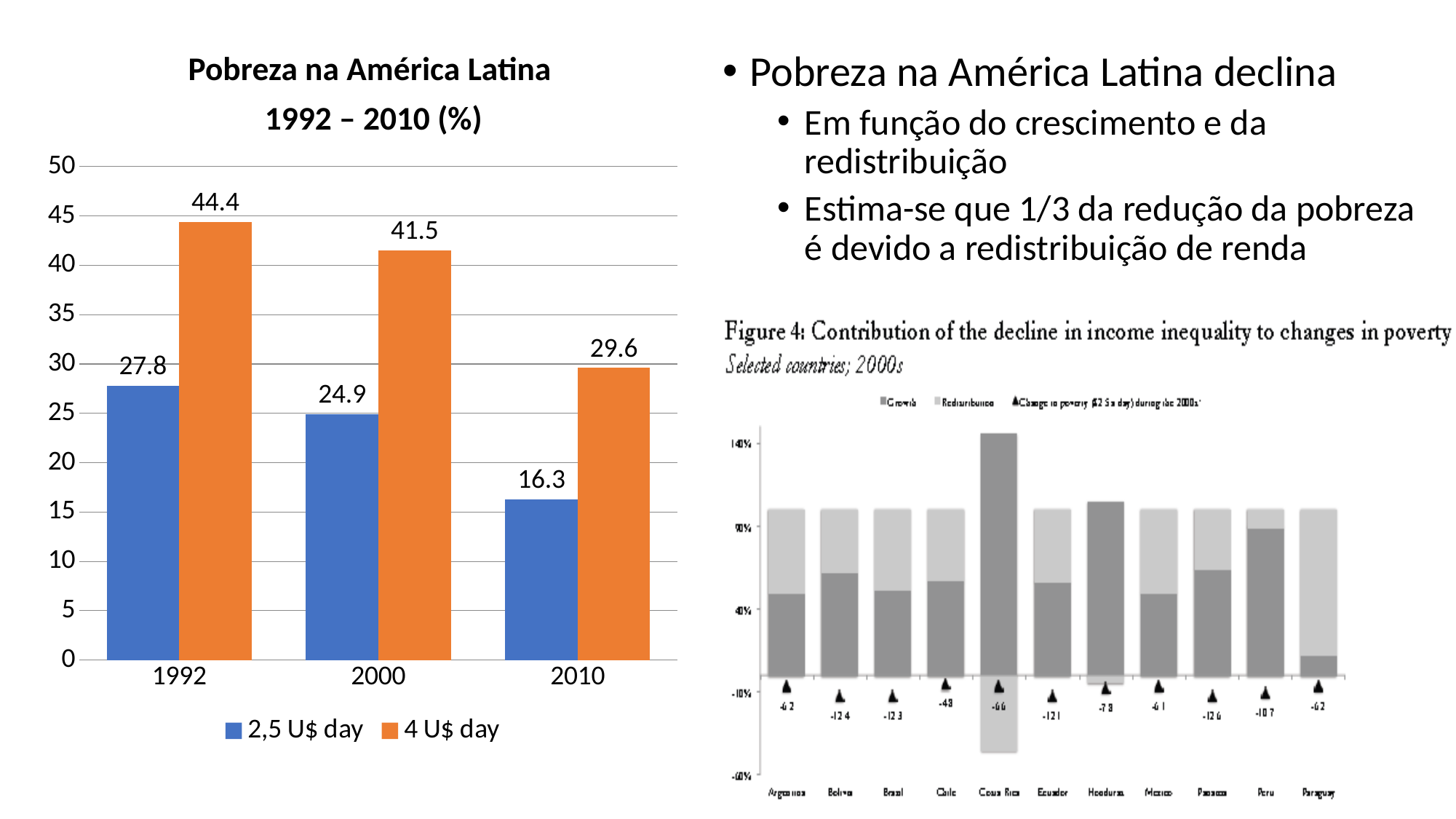
In the chart 'Pobreza na América Latina 1992 – 2010 (%)', what is the value for 4 U$ day in 1992? 44.4 What kind of chart is 'Pobreza na América Latina 1992 – 2010 (%)'? Bar chart In the chart 'Pobreza na América Latina 1992 – 2010 (%)', which year has the lowest value for 2,5 U$ day? 2010 In the chart 'Pobreza na América Latina 1992 – 2010 (%)', which series has the larger value in 2000, 2,5 U$ day or 4 U$ day? 4 U$ day In the chart 'Pobreza na América Latina 1992 – 2010 (%)', how many series does the legend list? 2 In the chart 'Pobreza na América Latina 1992 – 2010 (%)', what is the difference between the 4 U$ day and 2,5 U$ day values in 1992? 16.6 In the chart 'Pobreza na América Latina 1992 – 2010 (%)', do the 4 U$ day values rise or fall from 1992 to 2010? Fall In the chart 'Pobreza na América Latina 1992 – 2010 (%)', by how much did the 2,5 U$ day value fall from 1992 to 2010? 11.5 In the chart 'Pobreza na América Latina 1992 – 2010 (%)', which colour represents the 2,5 U$ day series? Blue In the chart 'Pobreza na América Latina 1992 – 2010 (%)', which year has the highest value for 4 U$ day? 1992 In the chart 'Pobreza na América Latina 1992 – 2010 (%)', how many years are shown on the x axis? 3 In the chart 'Pobreza na América Latina 1992 – 2010 (%)', what is the value for 2,5 U$ day in 2010? 16.3